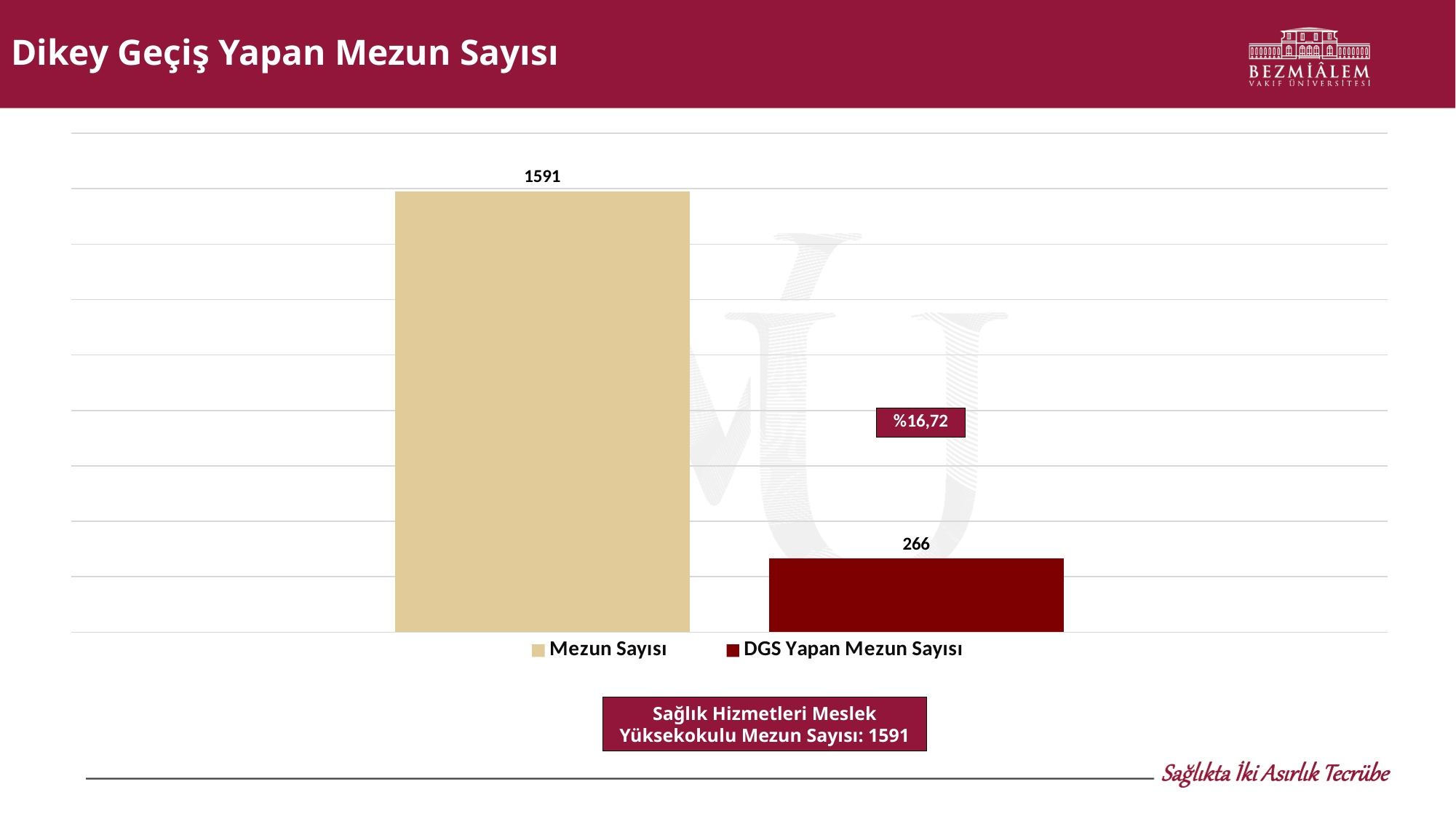
What is the value for DGS Yapan Mezun Sayısı? 266 How many bars are plotted in the chart? 2 What kind of chart is shown on the slide? bar chart Which bar is the lowest? DGS Yapan Mezun Sayısı What is the value for Mezun Sayısı? 1591 What percentage is shown in the label next to the DGS Yapan Mezun Sayısı bar? %16,72 What is the title of the slide? Dikey Geçiş Yapan Mezun Sayısı Which series has the higher value, Mezun Sayısı or DGS Yapan Mezun Sayısı? Mezun Sayısı How many series does the legend list? 2 What is the difference between Mezun Sayısı and DGS Yapan Mezun Sayısı? 1325